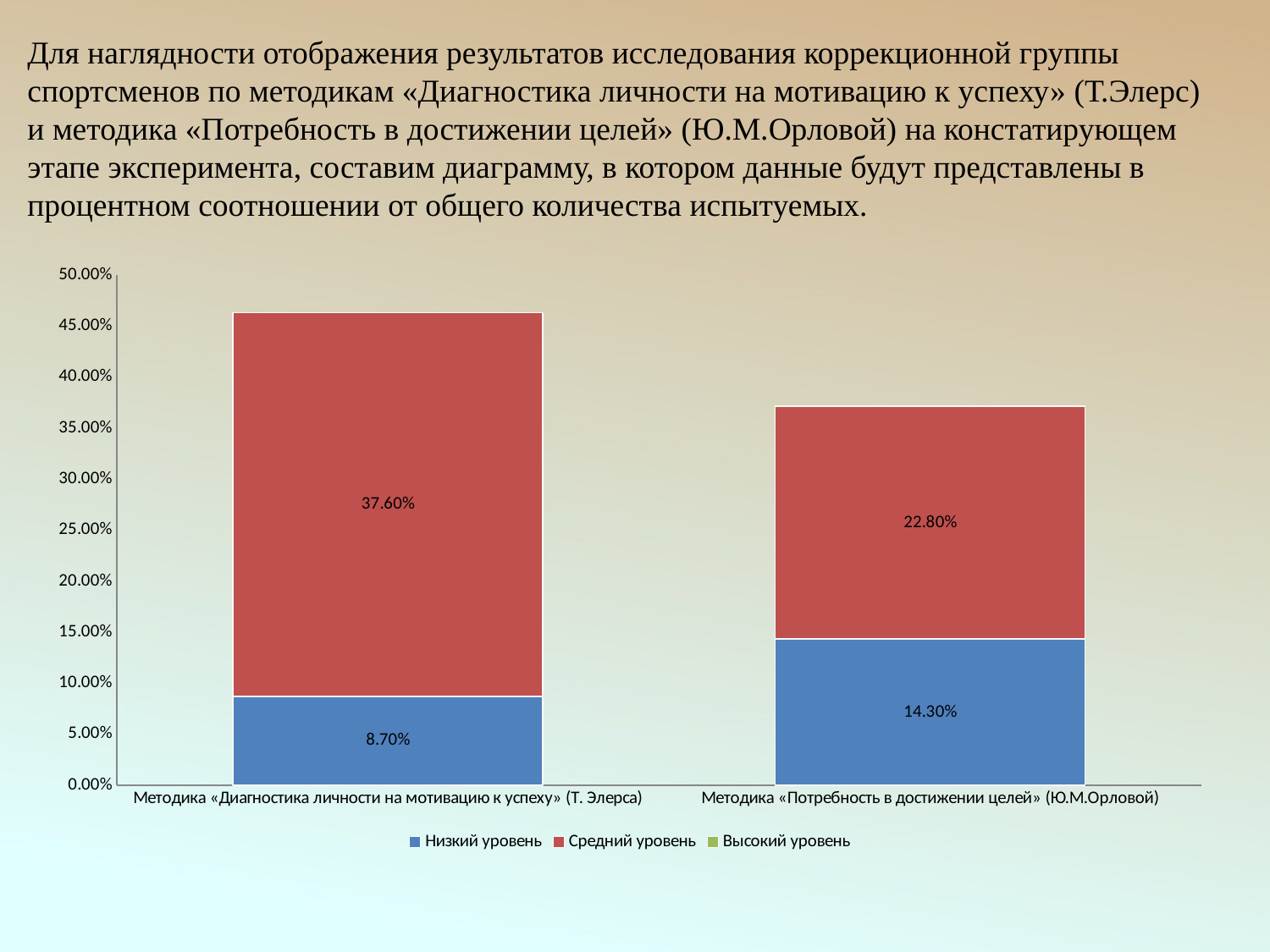
What is the value of «Средний уровень» for Методика «Диагностика личности на мотивацию к успеху» (Т. Элерса)? 37.60% How many categories are shown on the x axis? 2 What is the difference between the «Средний уровень» values for the Т. Элерса method and the Ю.М.Орловой method? 14.80% How many series does the legend list? 3 What is the difference between the «Низкий уровень» values for the Ю.М.Орловой method and the Т. Элерса method? 5.60% What kind of chart is shown on the slide? stacked bar chart What is the value of «Низкий уровень» for Методика «Диагностика личности на мотивацию к успеху» (Т. Элерса)? 8.70% Which method has the larger «Низкий уровень» value? Методика «Потребность в достижении целей» (Ю.М.Орловой) What is the value of «Низкий уровень» for Методика «Потребность в достижении целей» (Ю.М.Орловой)? 14.30% What is the value of «Средний уровень» for Методика «Потребность в достижении целей» (Ю.М.Орловой)? 22.80% Is the total height of the stacked bar for Методика «Диагностика личности на мотивацию к успеху» (Т. Элерса) greater or less than 45.00%? greater Which colour represents «Средний уровень» in the legend? red